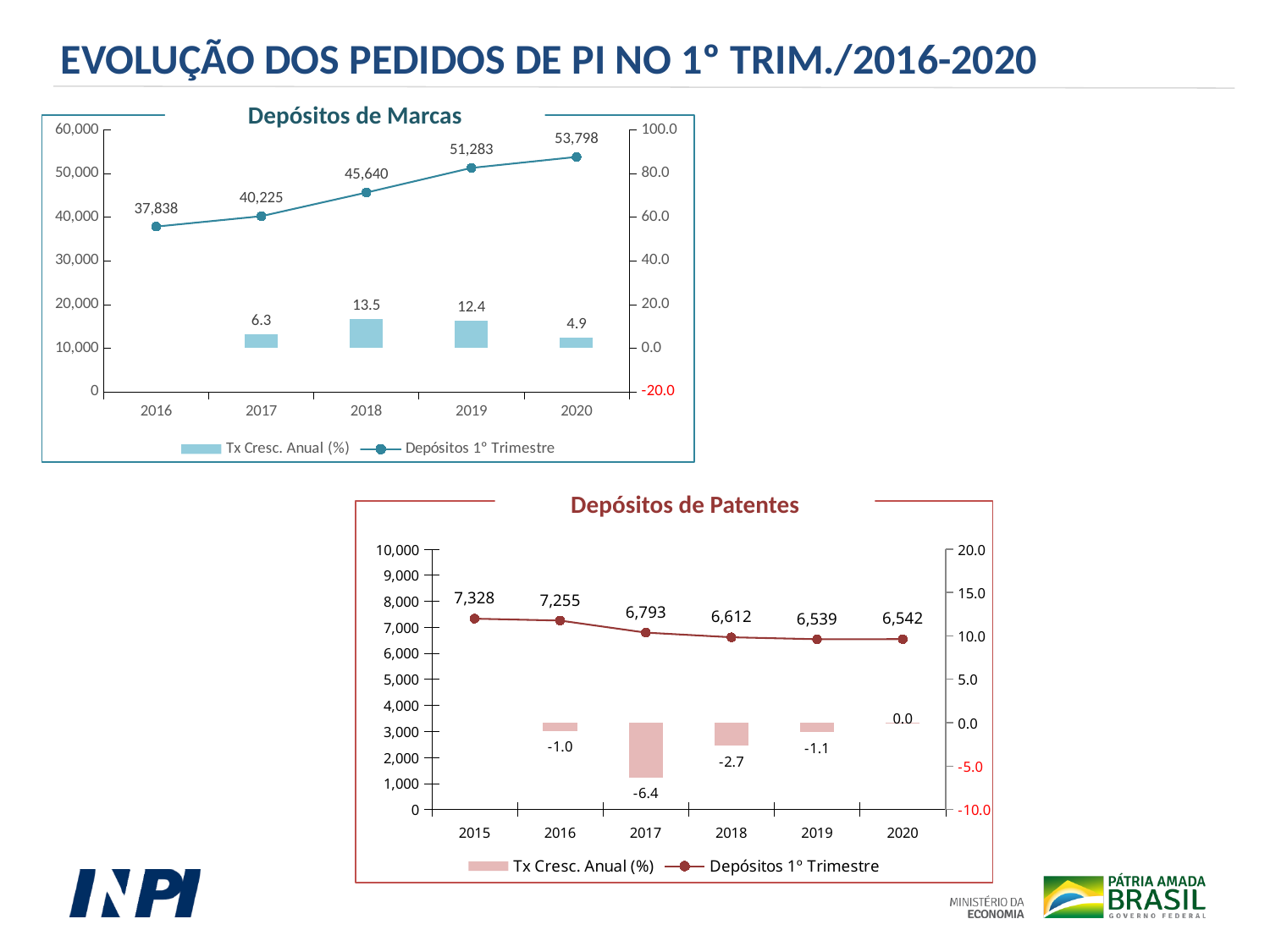
How many series does the legend of the 'Depósitos de Patentes' chart list? 2 In the 'Depósitos de Patentes' chart, which year has the highest Depósitos 1º Trimestre? 2015 In the 'Depósitos de Marcas' chart, which year has the highest Tx Cresc. Anual (%)? 2018 In the 'Depósitos de Patentes' chart, how many years are shown on the x axis? 6 In the 'Depósitos de Marcas' chart, what is the difference in Depósitos 1º Trimestre between 2020 and 2016? 15,960 In the 'Depósitos de Patentes' chart, what is the Tx Cresc. Anual (%) for 2018? -2.7 In the 'Depósitos de Marcas' chart, what is the Tx Cresc. Anual (%) for 2019? 12.4 In the 'Depósitos de Patentes' chart, what is the value of Depósitos 1º Trimestre for 2017? 6,793 In the 'Depósitos de Marcas' chart, does Depósitos 1º Trimestre rise or fall from 2016 to 2020? rise In the 'Depósitos de Patentes' chart, is Depósitos 1º Trimestre for 2019 larger or smaller than for 2016? smaller In the 'Depósitos de Patentes' chart, which year has the lowest Tx Cresc. Anual (%)? 2017 In the 'Depósitos de Marcas' chart, what is the value of Depósitos 1º Trimestre for 2018? 45,640